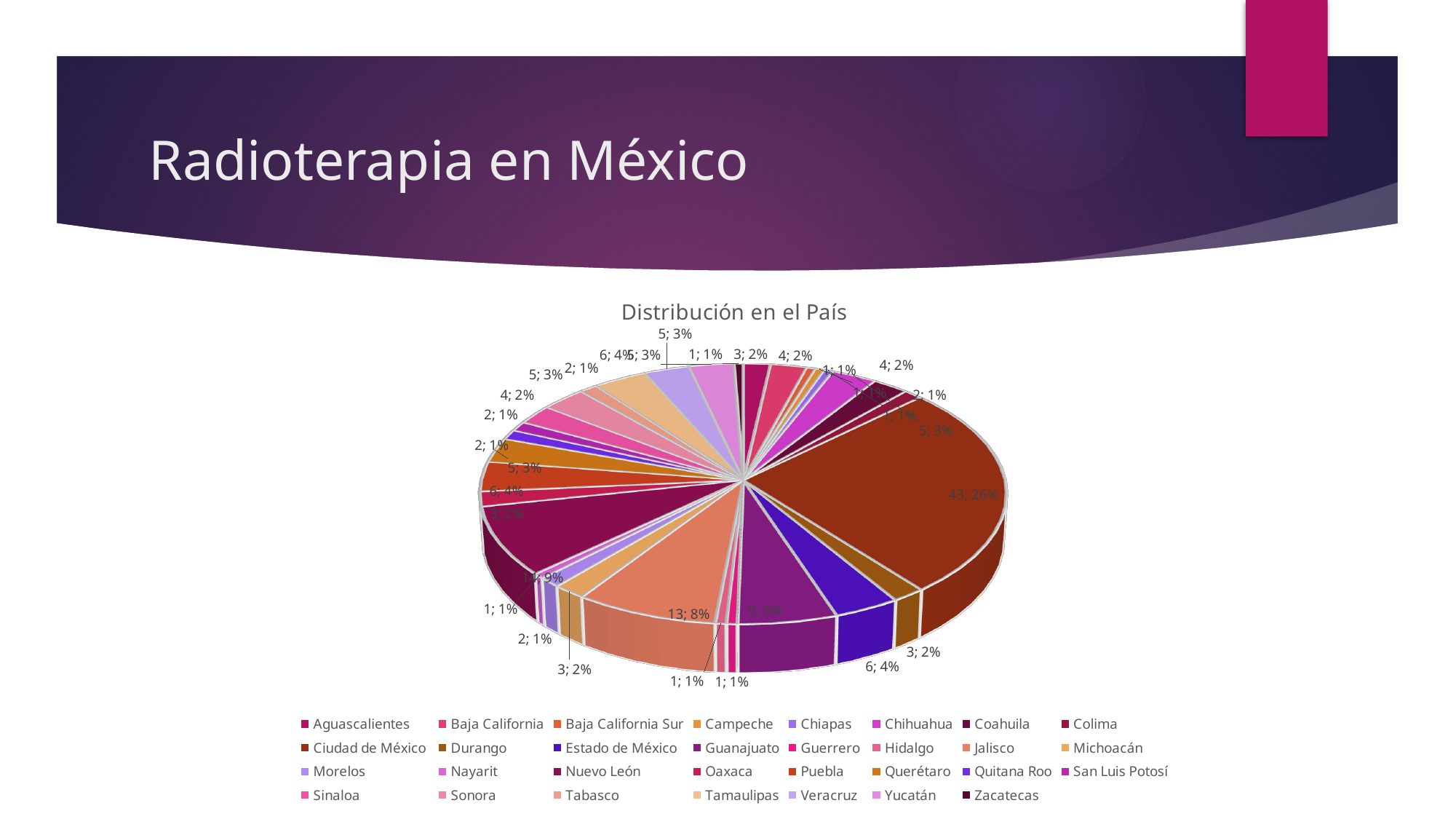
What percentage share does Jalisco have? 8% What is the value shown for Estado de México? 6 What kind of chart is shown on the slide? Pie chart What is the value shown for Ciudad de México? 43 What percentage share does Guanajuato have? 6% Which is larger, the value for Nuevo León or the value for Jalisco? Nuevo León What percentage share of the pie does Ciudad de México have? 26% What is the difference between the values for Ciudad de México and Nuevo León? 29 What is the title of the chart? Distribución en el País What is the value shown for Nuevo León? 14 Which state has the largest slice of the pie? Ciudad de México How many states are listed in the chart legend? 31